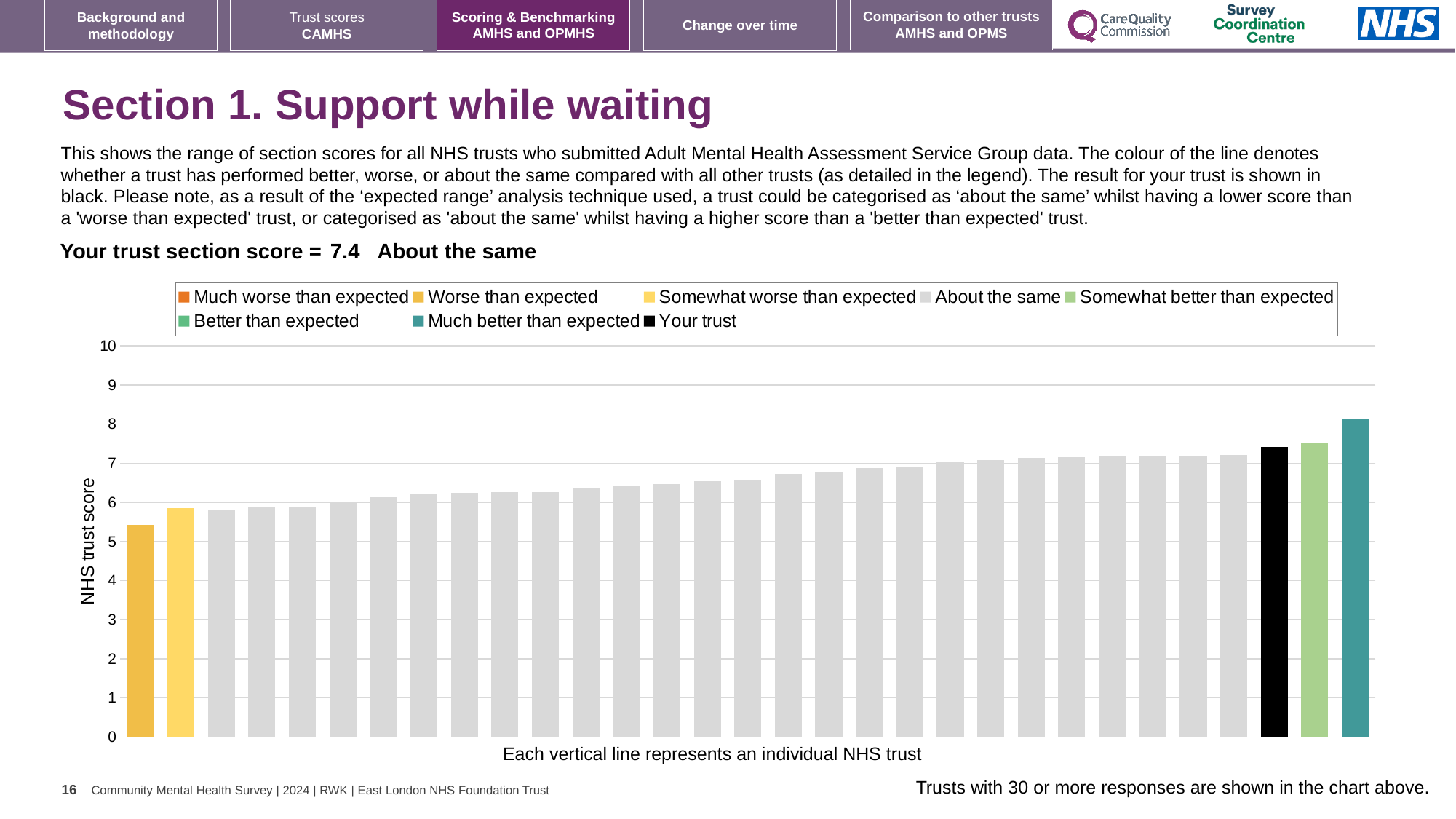
Is the value of the black 'Your trust' bar greater or less than 7? greater What kind of chart is shown on the slide? bar chart How many entries does the chart legend list? 8 Is the value of the leftmost bar greater or less than 6? less What is the section score for your trust shown on the slide? 7.4 What is the label on the vertical axis of the chart? NHS trust score What does each vertical line in the chart represent, according to the x-axis label? an individual NHS trust Is the value of the rightmost (teal) bar greater or less than 7? greater Do the bar values rise or fall from left to right across the chart? rise Which legend category does the highest bar in the chart belong to? Much better than expected Which is larger, the black 'Your trust' bar or the rightmost teal bar? the rightmost teal bar How is your trust's section score categorised compared with other trusts? About the same